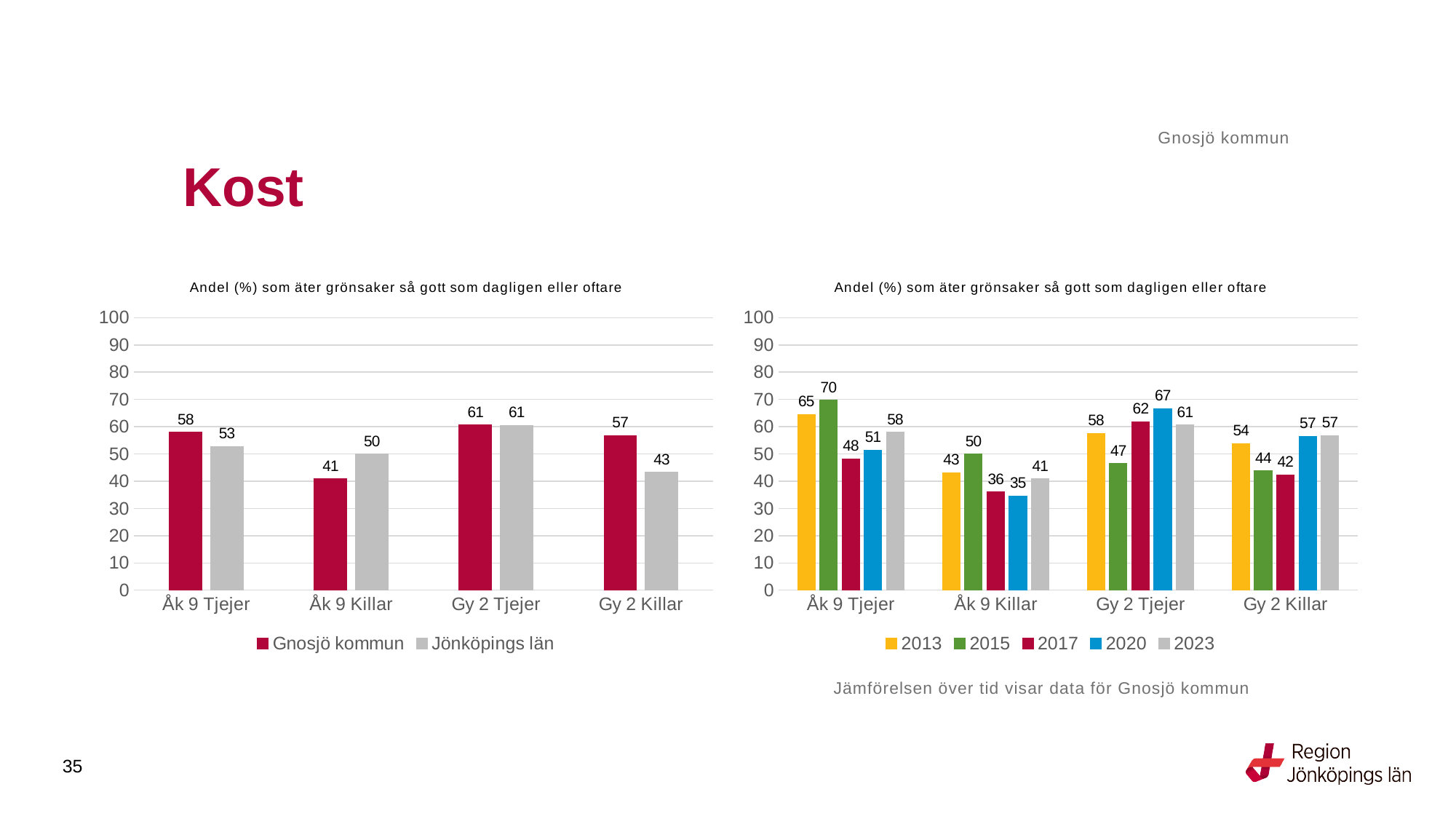
In the left chart, what is the difference between Gnosjö kommun and Jönköpings län for Gy 2 Killar? 14 What kind of chart is the right chart? Bar chart In the right chart, how many series does the legend list? 5 In the right chart, which year has the lowest value for Åk 9 Killar? 2020 In the right chart, what is the value for 2015 for Åk 9 Tjejer? 70 In the left chart, what is the value for Jönköpings län for Gy 2 Killar? 43 In the left chart, which category has the lowest value for Gnosjö kommun? Åk 9 Killar In the left chart, what is the value for Gnosjö kommun for Åk 9 Killar? 41 In the left chart, how many series does the legend list? 2 In the right chart, which is larger for Gy 2 Killar: 2013 or 2017? 2013 In the right chart, what is the difference between 2015 and 2017 for Åk 9 Tjejer? 22 In the right chart, what is the value for 2020 for Gy 2 Tjejer? 67